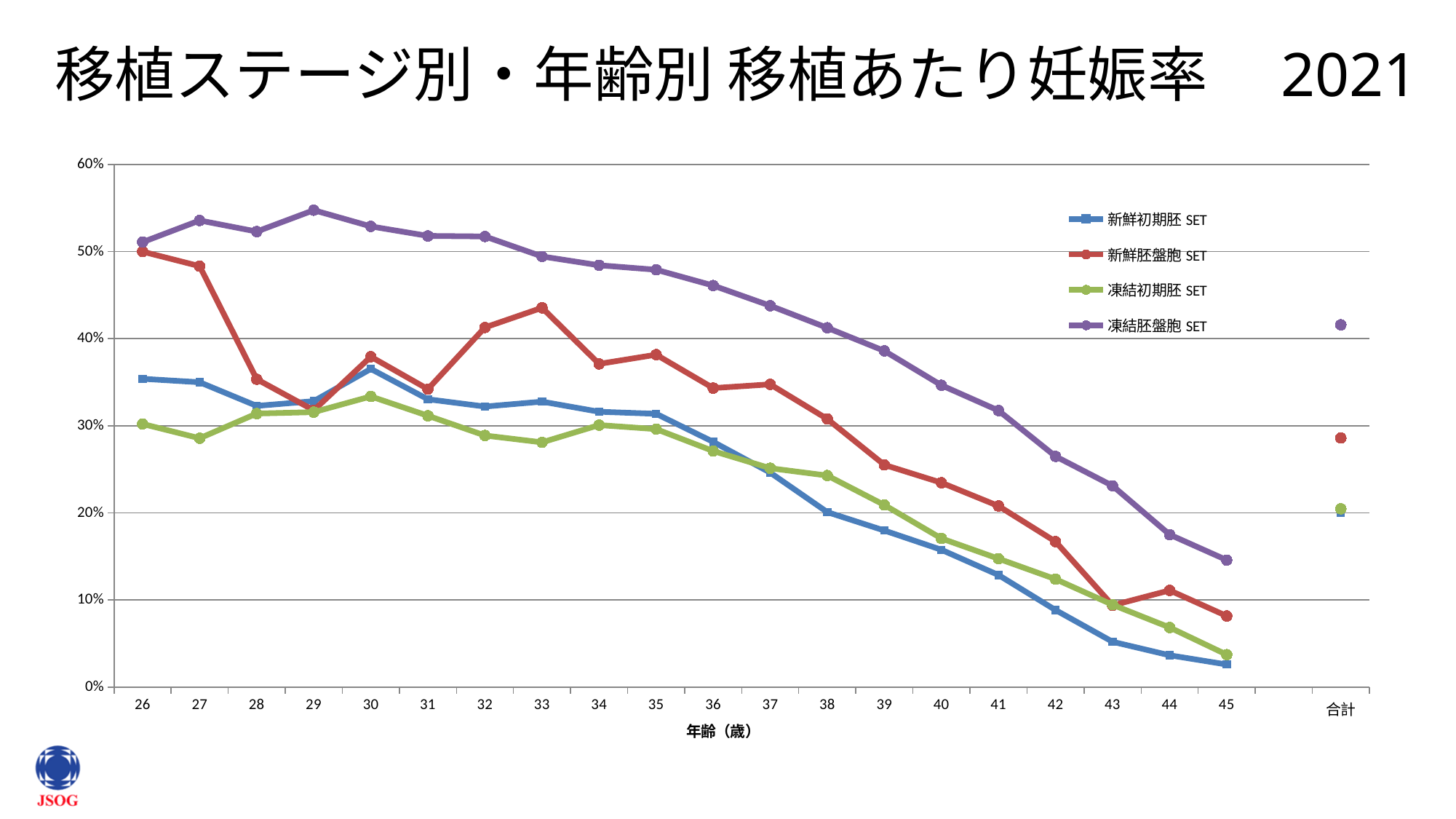
How many series does the legend list? 4 What is the x-axis title of the chart? 年齢（歳） Is the value for 新鮮初期胚 SET at age 45 greater or less than 10%? less At age 40, which is larger: 新鮮胚盤胞 SET or 凍結初期胚 SET? 新鮮胚盤胞 SET At which age is the 新鮮初期胚 SET series lowest? 45 Is the 合計 value for 凍結胚盤胞 SET greater or less than 40%? greater Which series has the highest value at age 29? 凍結胚盤胞 SET Does the 凍結胚盤胞 SET series rise or fall from age 30 to age 45? fall Is the value for 凍結胚盤胞 SET at age 29 greater or less than 50%? greater How many age categories (excluding 合計) are shown on the x axis? 20 At which age does the 凍結胚盤胞 SET series reach its highest value? 29 What kind of chart is shown on the slide? line chart